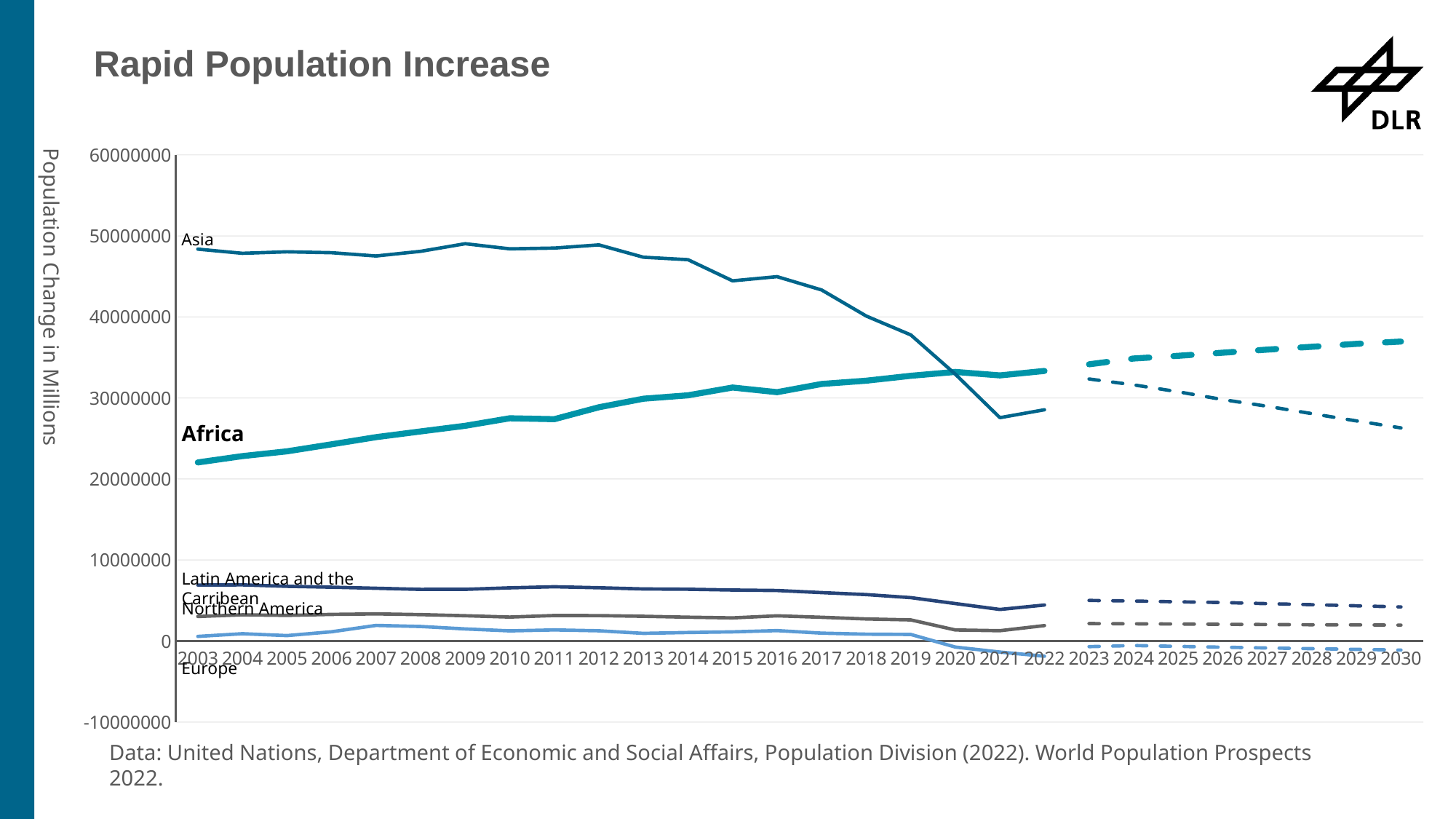
What kind of chart is shown on the slide? line chart Is the value for Africa in 2003 greater or less than 30000000? less How many series are plotted on the chart? 5 Does the Africa line rise or fall between 2003 and 2030? rise In 2003, which is larger, the value for Asia or the value for Africa? Asia What is the title of the chart? Rapid Population Increase Does the Asia line rise or fall between 2003 and 2022? fall Is the value for Asia in 2003 greater or less than 40000000? greater Which series has the highest value in 2030? Africa How many years are shown along the x axis? 28 What is the label of the vertical axis? Population Change in Millions Is the value for Europe in 2030 greater or less than 0? less